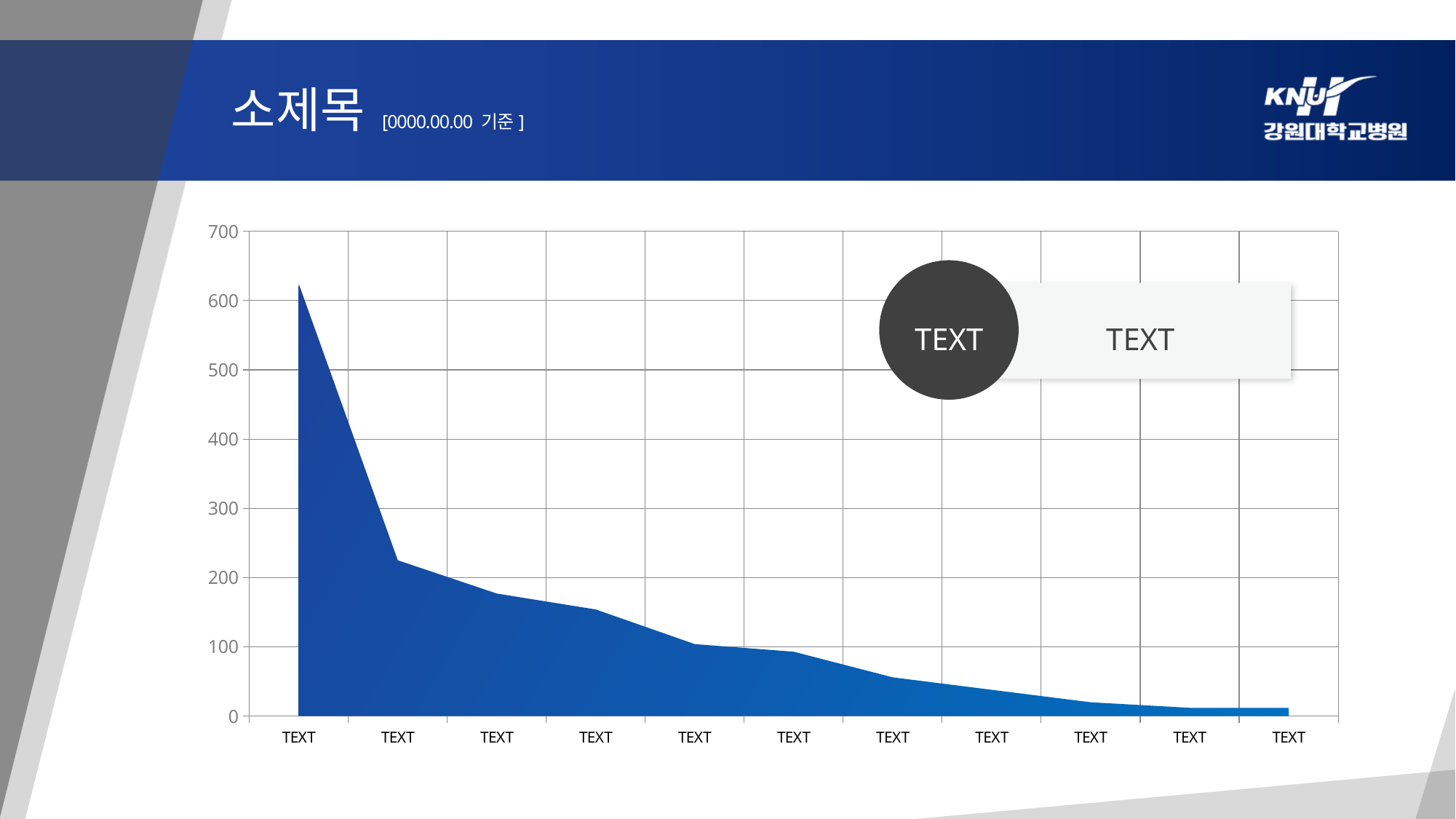
Which data point has the lowest value? the last two points (tenth and eleventh) are tied for the lowest Which is larger, the value of the first point or the value of the second point? the first point What is the title text shown in the header bar of the slide? 소제목 Do the values rise or fall from left to right along the x axis? fall Is the value of the first (leftmost) point greater or less than 600? greater Which data point has the highest value? the first (leftmost) point What is the maximum value shown on the vertical axis? 700 Is the value of the second point from the left greater or less than 300? less Is the value of the third point from the left greater or less than 100? greater What kind of chart is shown on the slide? area chart How many data points (categories) are plotted along the x axis? 11